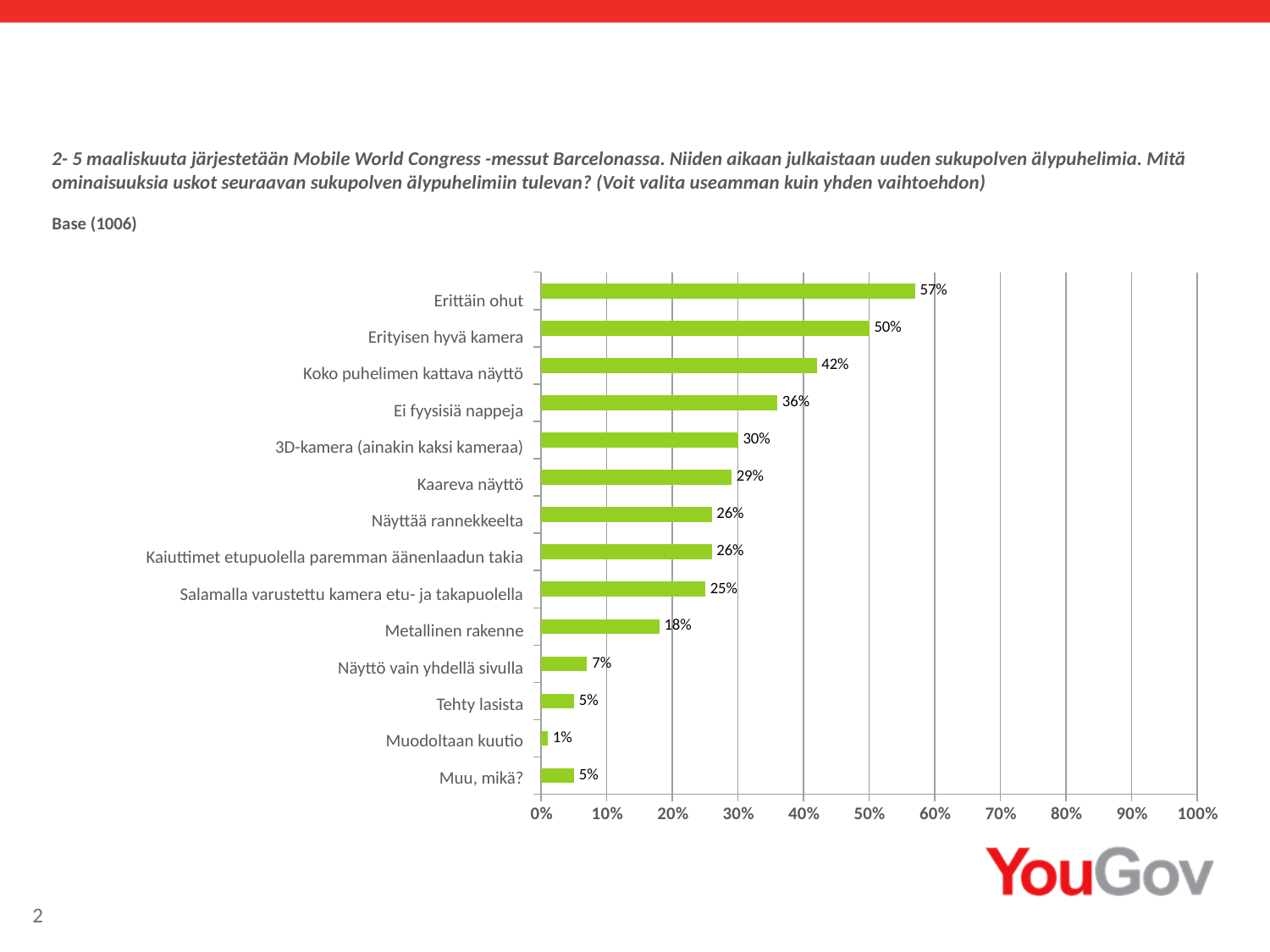
What is the value for "Kaareva näyttö"? 29% Which category has the highest value? Erittäin ohut Is the value for "Salamalla varustettu kamera etu- ja takapuolella" greater or less than 30%? less What is the difference between the values for "Erityisen hyvä kamera" and "Koko puhelimen kattava näyttö"? 8% What is the value for "Erittäin ohut"? 57% What is the value for "Metallinen rakenne"? 18% How many categories are shown in the chart? 14 What kind of chart is shown on the slide? bar chart What is the base (number of respondents) shown on the slide? 1006 Which category has the lowest value? Muodoltaan kuutio Which is larger, the value for "Ei fyysisiä nappeja" or the value for "3D-kamera (ainakin kaksi kameraa)"? Ei fyysisiä nappeja What is the value for "Näyttö vain yhdellä sivulla"? 7%